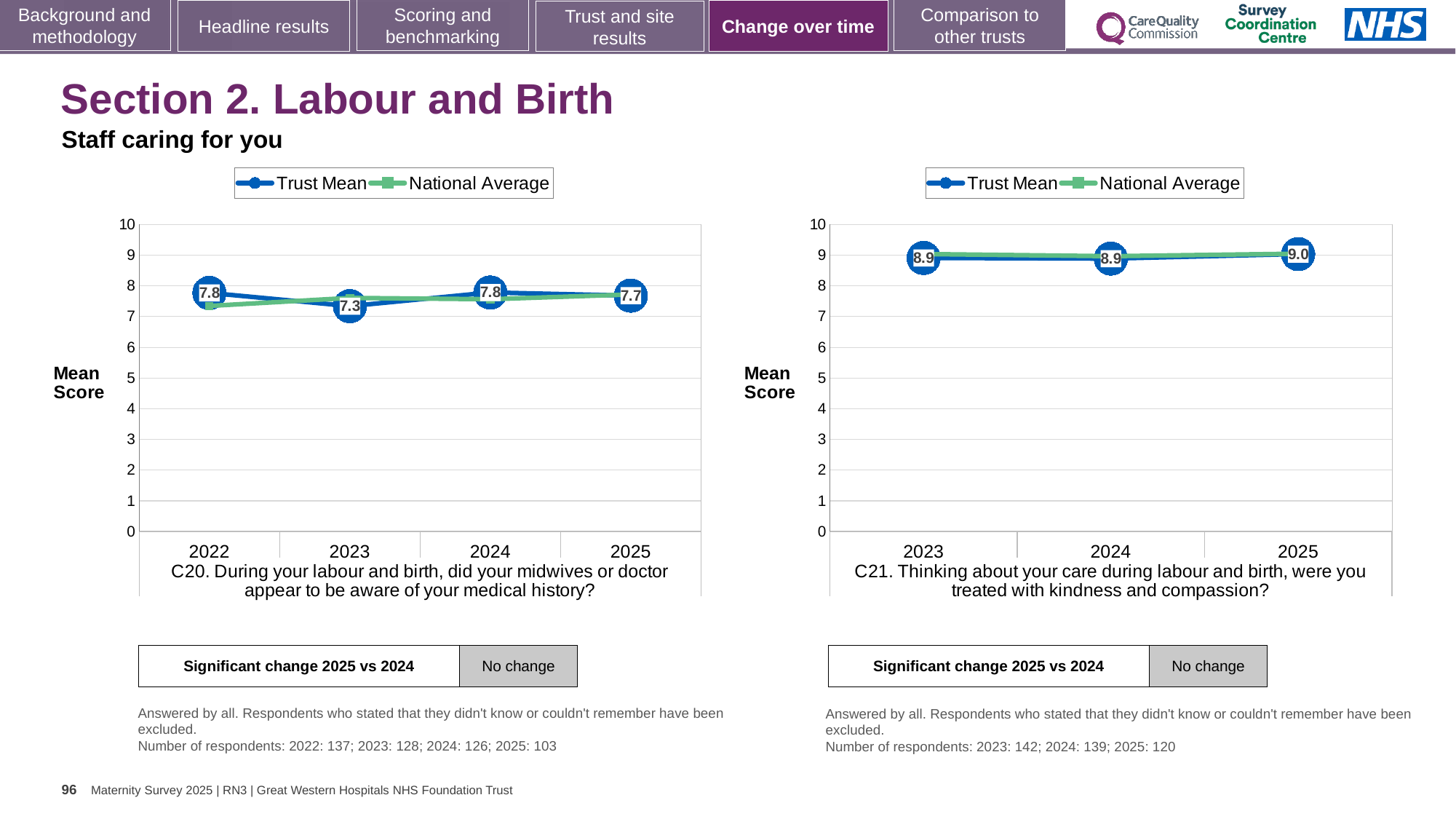
In the C20 chart on the left, which year has the lowest Trust Mean score? 2023 In the C20 chart on the left, is the National Average value for 2022 greater or less than 8? less How many series does the legend of the C21 chart on the right list? 2 What kind of chart is the C20 chart on the left? Line chart In the C21 chart on the right, what is the Trust Mean score for 2023? 8.9 In the C20 chart on the left, what is the difference between the Trust Mean scores for 2022 and 2023? 0.5 In the C20 chart on the left, how many years are plotted on the x axis? 4 In the C21 chart on the right, how many years are plotted on the x axis? 3 In the C20 chart on the left, what is the Trust Mean score for 2025? 7.7 In the C20 chart on the left, what is the Trust Mean score for 2023? 7.3 In the C21 chart on the right, is the Trust Mean value for 2024 greater or less than 8? greater In the C21 chart on the right, what is the Trust Mean score for 2025? 9.0